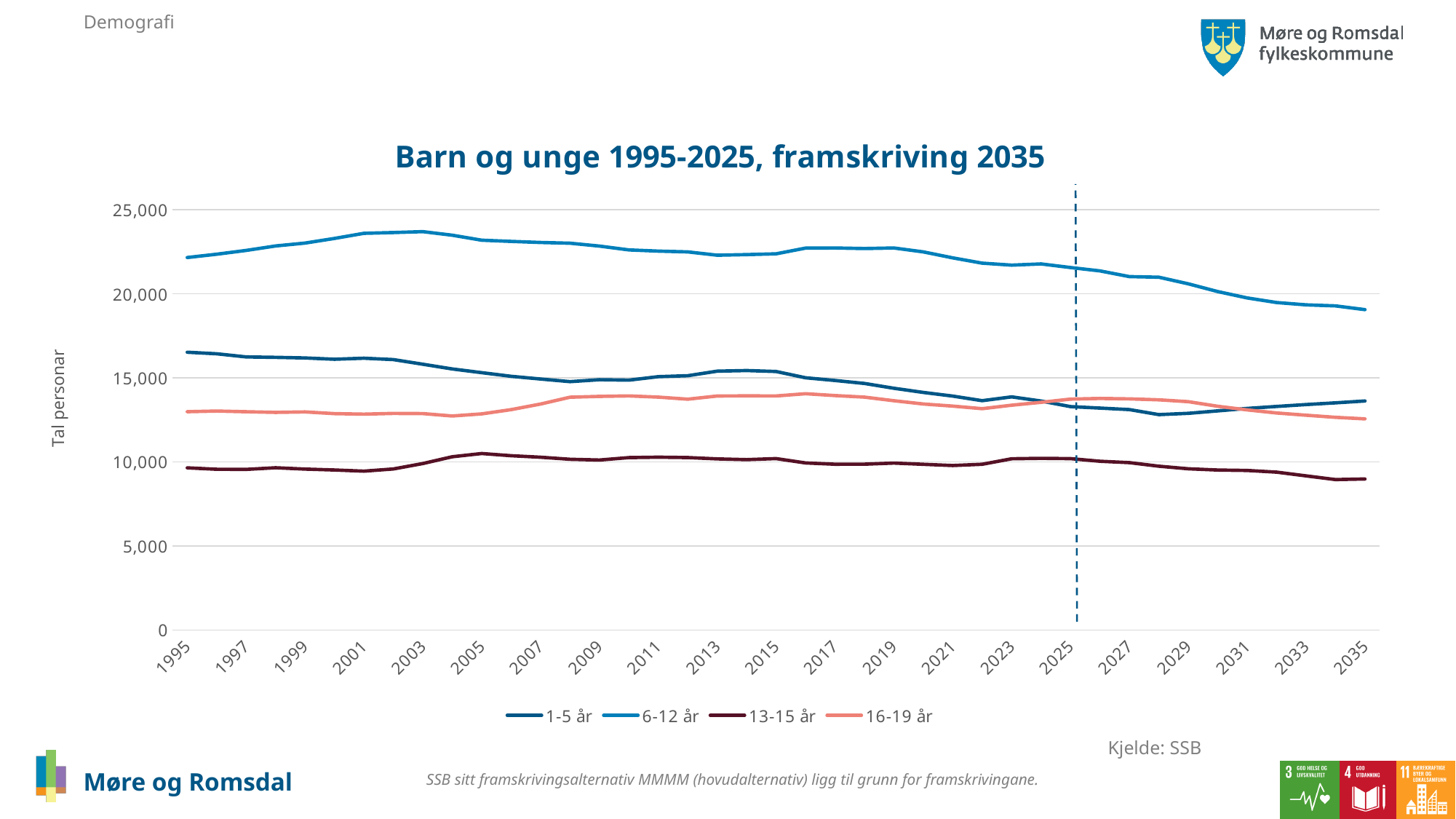
Does the 6-12 år line rise or fall between 2019 and 2035? fall How many series does the legend list? 4 Which age group has the lowest values throughout the chart? 13-15 år What is the title of the chart? Barn og unge 1995-2025, framskriving 2035 Which is larger in 1995: the value for 1-5 år or the value for 16-19 år? 1-5 år What is the label on the vertical axis? Tal personar Which age group has the highest values throughout the chart? 6-12 år What kind of chart is shown on the slide? line chart Is the value for 1-5 år in 1995 greater or less than 15,000? greater Is the value for 13-15 år in 2035 greater or less than 10,000? less Is the value for 6-12 år in 2035 greater or less than 20,000? less